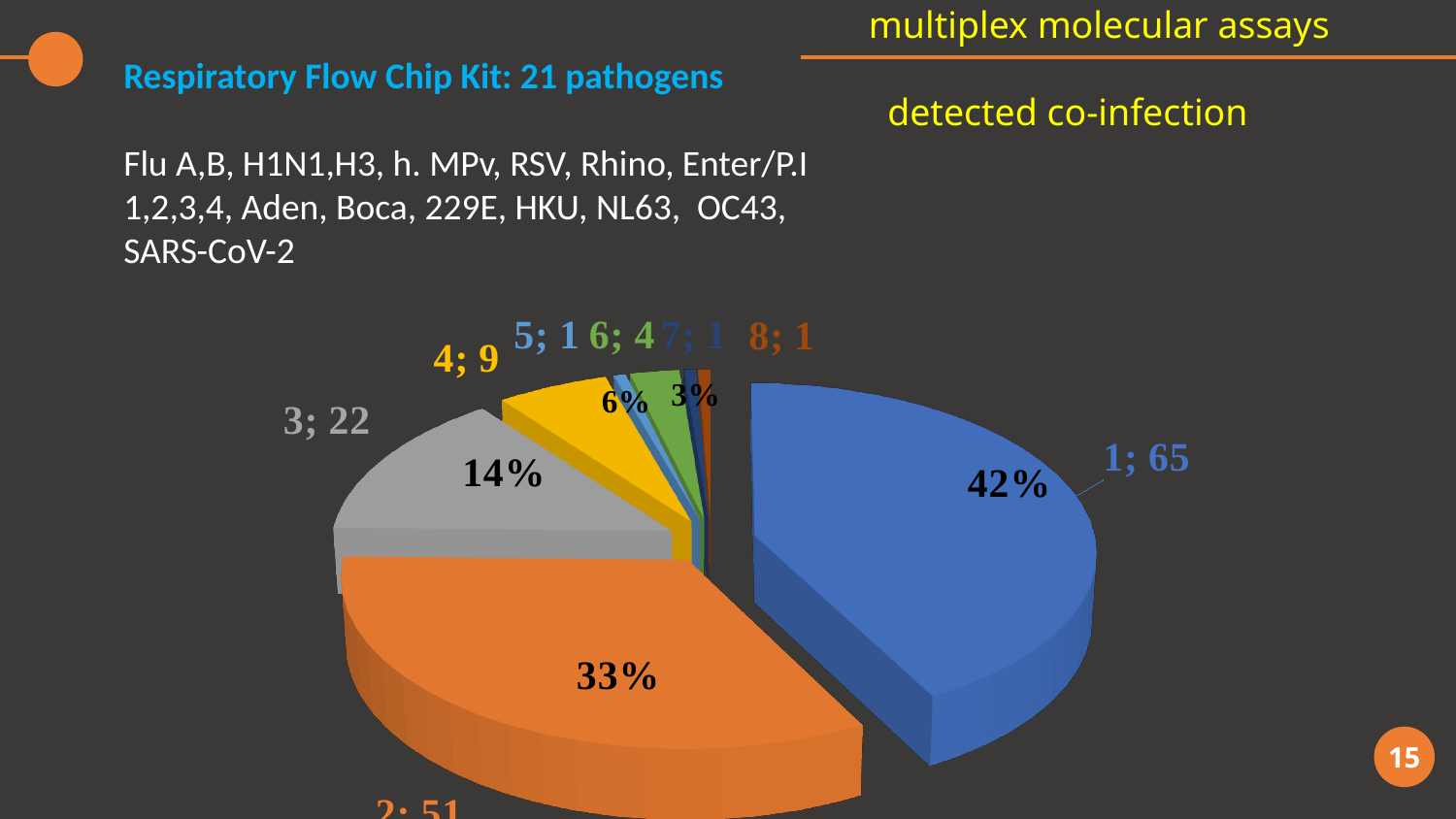
What kind of chart is shown on the slide? Pie chart Which category has the largest slice in the pie chart? 1 Which has the larger value, category 4 or category 6? Category 4 How many slices does the pie chart have? 8 What is the value shown for category 6 in the pie chart? 4 What is the difference between the values for category 1 and category 3? 43 What colour is the largest slice of the pie chart? Blue What is the value shown for category 4 in the pie chart? 9 What percentage share of the pie does category 1 have? 42% What is the value shown for category 3 in the pie chart? 22 What percentage share of the pie does category 3 have? 14% What percentage share of the pie does category 4 have? 6%